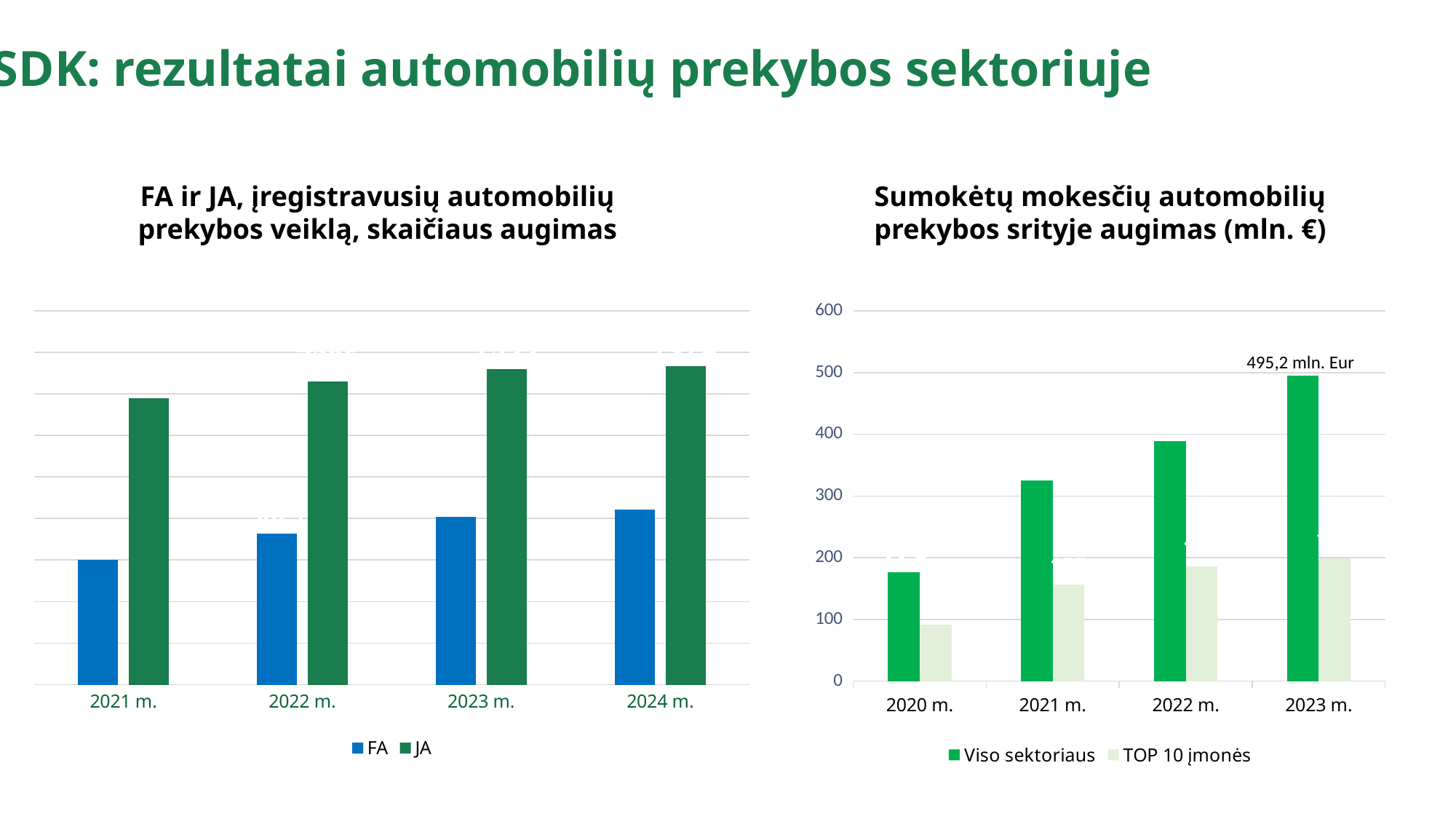
In the right chart, is the value for TOP 10 įmonės in 2020 m. greater or less than 100? less What kind of chart is the left chart titled "FA ir JA, įregistravusių automobilių prekybos veiklą, skaičiaus augimas"? Bar chart In the right chart, what is the value for Viso sektoriaus in 2023 m.? 495,2 mln. Eur How many series does the legend of the left chart list? 2 In the right chart, which year has the highest Viso sektoriaus value? 2023 m. How many years are shown on the x axis of the left chart? 4 In the right chart, do the Viso sektoriaus values rise or fall from 2020 m. to 2023 m.? Rise In the left chart, which series has the taller bar in 2021 m., FA or JA? JA How many series does the legend of the right chart list? 2 In the right chart, is the value for Viso sektoriaus in 2020 m. greater or less than 200? less In the left chart, do the FA values rise or fall from 2021 m. to 2024 m.? Rise In the left chart, which year has the lowest FA value? 2021 m.